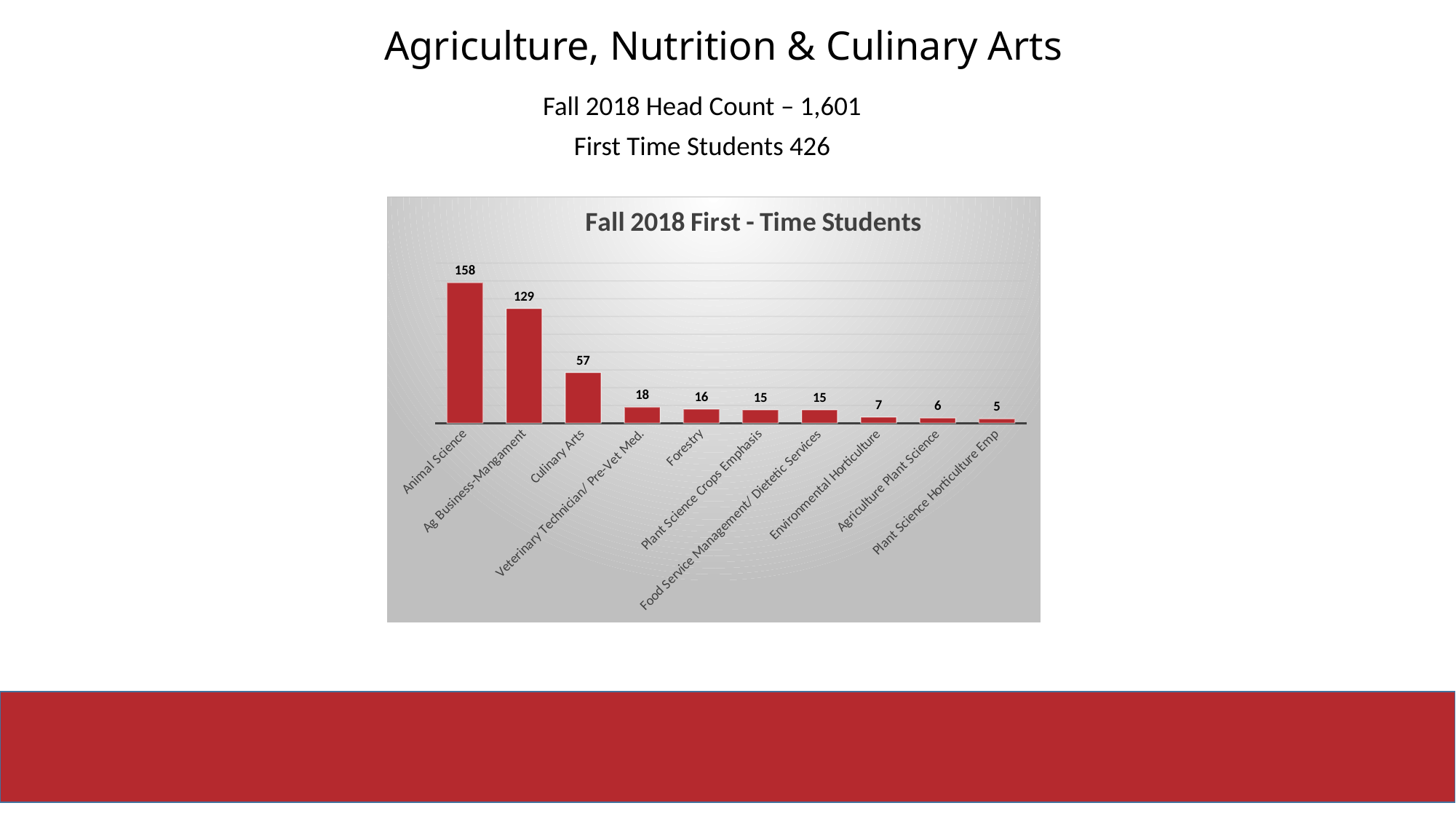
Which category has the highest value? Animal Science What is the difference between the values for Animal Science and Ag Business-Mangament? 29 What is the value for Culinary Arts? 57 Do the values rise or fall from left to right along the x axis? Fall What kind of chart is shown? Bar chart Which is larger, the value for Environmental Horticulture or the value for Agriculture Plant Science? Environmental Horticulture What is the title of the chart? Fall 2018 First - Time Students What is the difference between the values for Culinary Arts and Veterinary Technician/ Pre-Vet Med.? 39 What is the value for Forestry? 16 What is the value for Animal Science? 158 How many categories are shown on the chart? 10 Which category has the lowest value? Plant Science Horticulture Emp